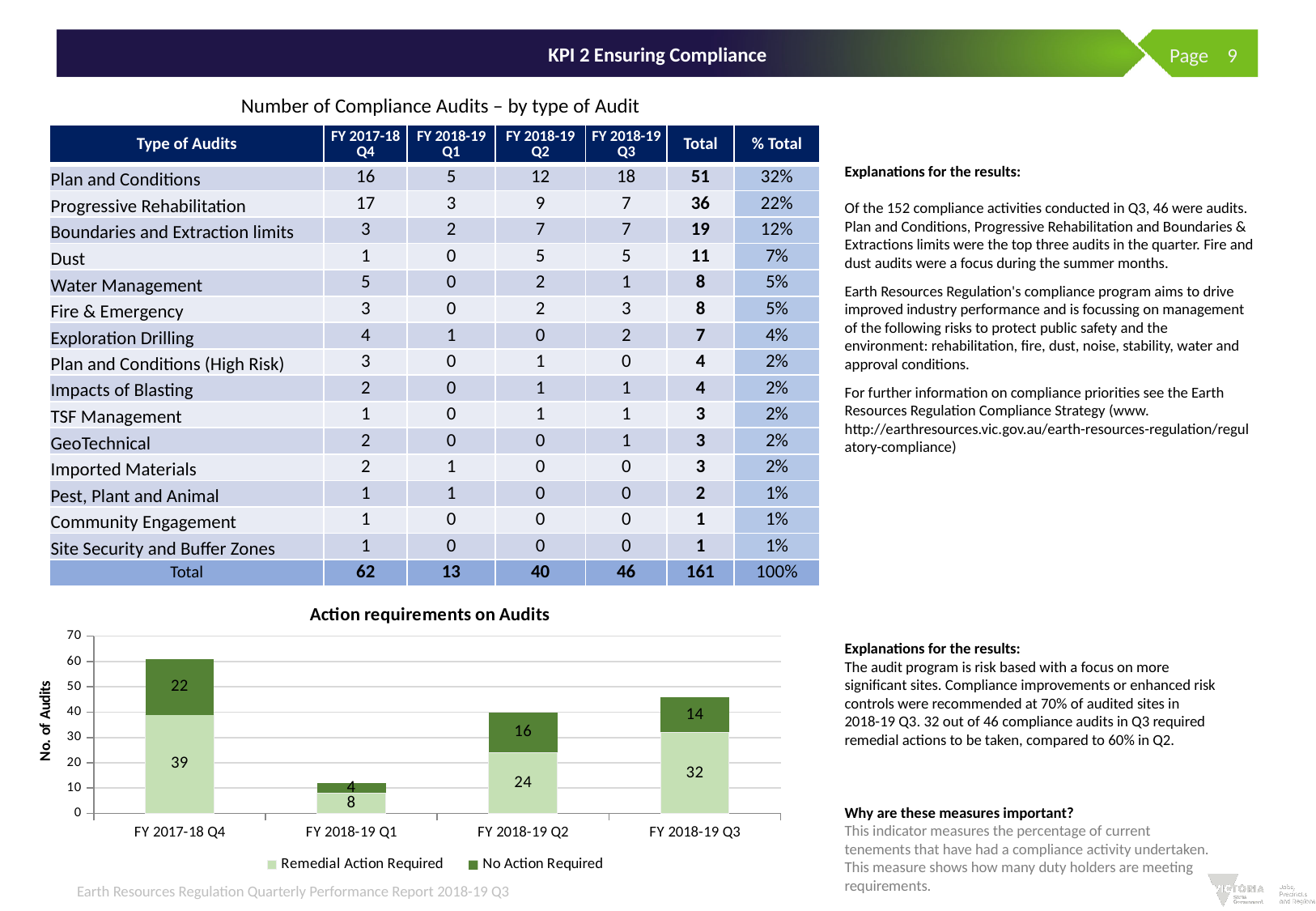
What kind of chart is 'Action requirements on Audits'? Stacked bar chart In the 'Action requirements on Audits' chart, which quarter has the lowest value for No Action Required? FY 2018-19 Q1 In the 'Action requirements on Audits' chart, what is the value for No Action Required in FY 2018-19 Q3? 14 How many quarters are shown on the x axis of the 'Action requirements on Audits' chart? 4 In the 'Action requirements on Audits' chart, which quarter has the highest value for Remedial Action Required? FY 2017-18 Q4 How many series does the legend of the 'Action requirements on Audits' chart list? 2 In the 'Action requirements on Audits' chart, what is the value for Remedial Action Required in FY 2017-18 Q4? 39 In the 'Action requirements on Audits' chart, which is larger: No Action Required in FY 2017-18 Q4 or No Action Required in FY 2018-19 Q2? FY 2017-18 Q4 In the 'Action requirements on Audits' chart, what is the total height of the stacked bar for FY 2017-18 Q4? 61 In the 'Action requirements on Audits' chart, what is the difference between Remedial Action Required in FY 2018-19 Q3 and FY 2018-19 Q2? 8 In the 'Action requirements on Audits' chart, what is the value for No Action Required in FY 2018-19 Q1? 4 In the 'Action requirements on Audits' chart, what is the total height of the stacked bar for FY 2018-19 Q3? 46